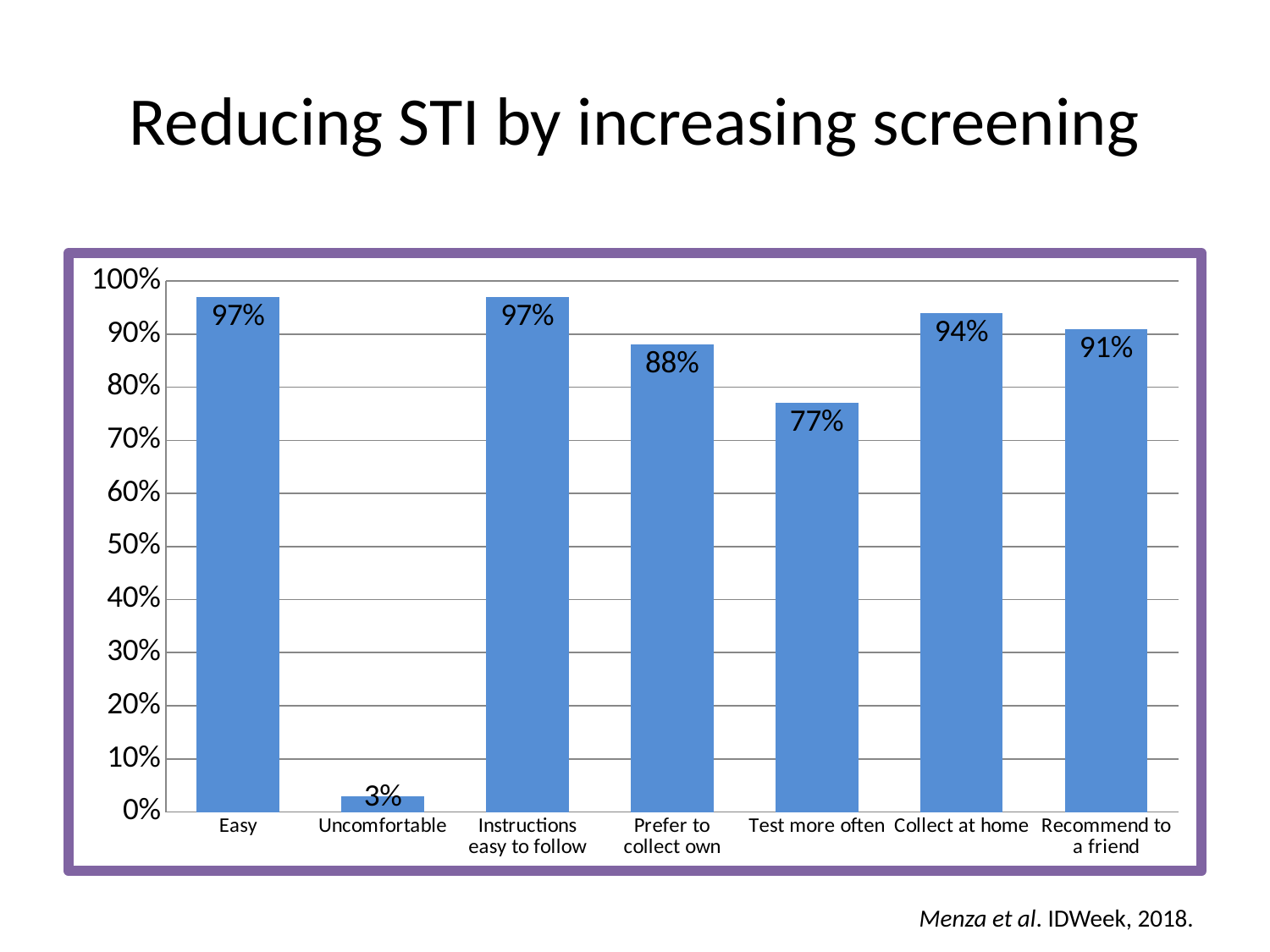
What is the title of the slide containing the chart? Reducing STI by increasing screening Is the value for Prefer to collect own greater or less than 80%? greater What is the value for Recommend to a friend? 91% What is the value for Test more often? 77% What is the value for Easy? 97% Which category has the lowest value? Uncomfortable How many categories are shown on the x axis? 7 What is the value for Collect at home? 94% What is the value for Uncomfortable? 3% What is the difference between the values for Prefer to collect own and Test more often? 11% Which is larger, the value for Collect at home or the value for Recommend to a friend? Collect at home What kind of chart is shown on the slide? Bar chart